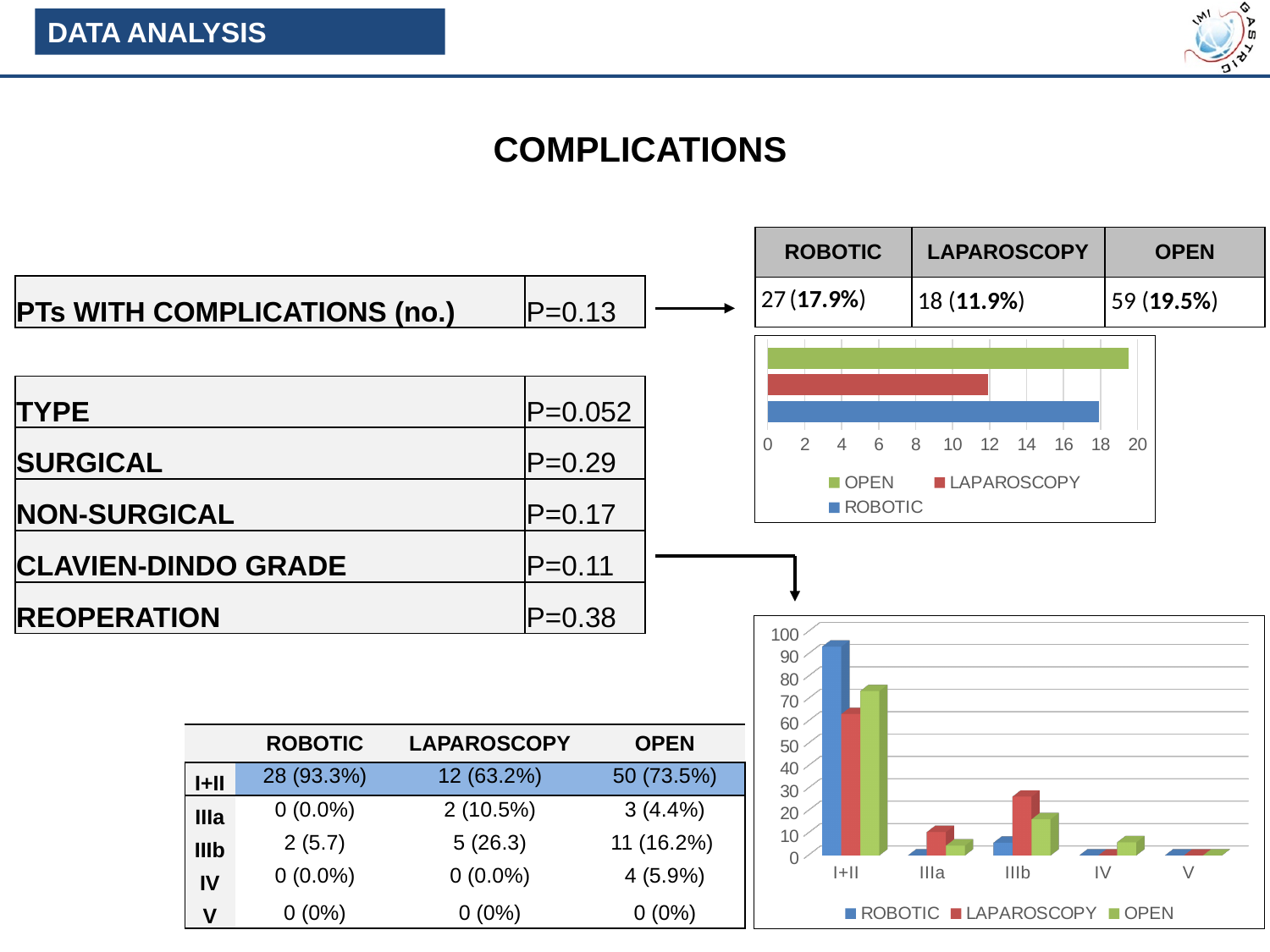
In the lower bar chart on the right, which colour represents OPEN in the legend? green In the upper bar chart on the right, is the value for OPEN greater or less than 18? greater What kind of chart is the upper chart on the right of the slide? bar chart In the lower bar chart on the right, which category has the highest ROBOTIC bar? I+II In the upper bar chart on the right, which group has the longest bar? OPEN In the upper bar chart on the right, is the value for LAPAROSCOPY greater or less than 10? greater In the upper bar chart on the right, which is larger, the ROBOTIC bar or the LAPAROSCOPY bar? ROBOTIC In the lower bar chart on the right, is the LAPAROSCOPY value for IIIb greater or less than 20? greater In the upper bar chart on the right, which group has the shortest bar? LAPAROSCOPY How many categories are shown on the x axis of the lower bar chart on the right? 5 How many series does the legend of the upper bar chart on the right list? 3